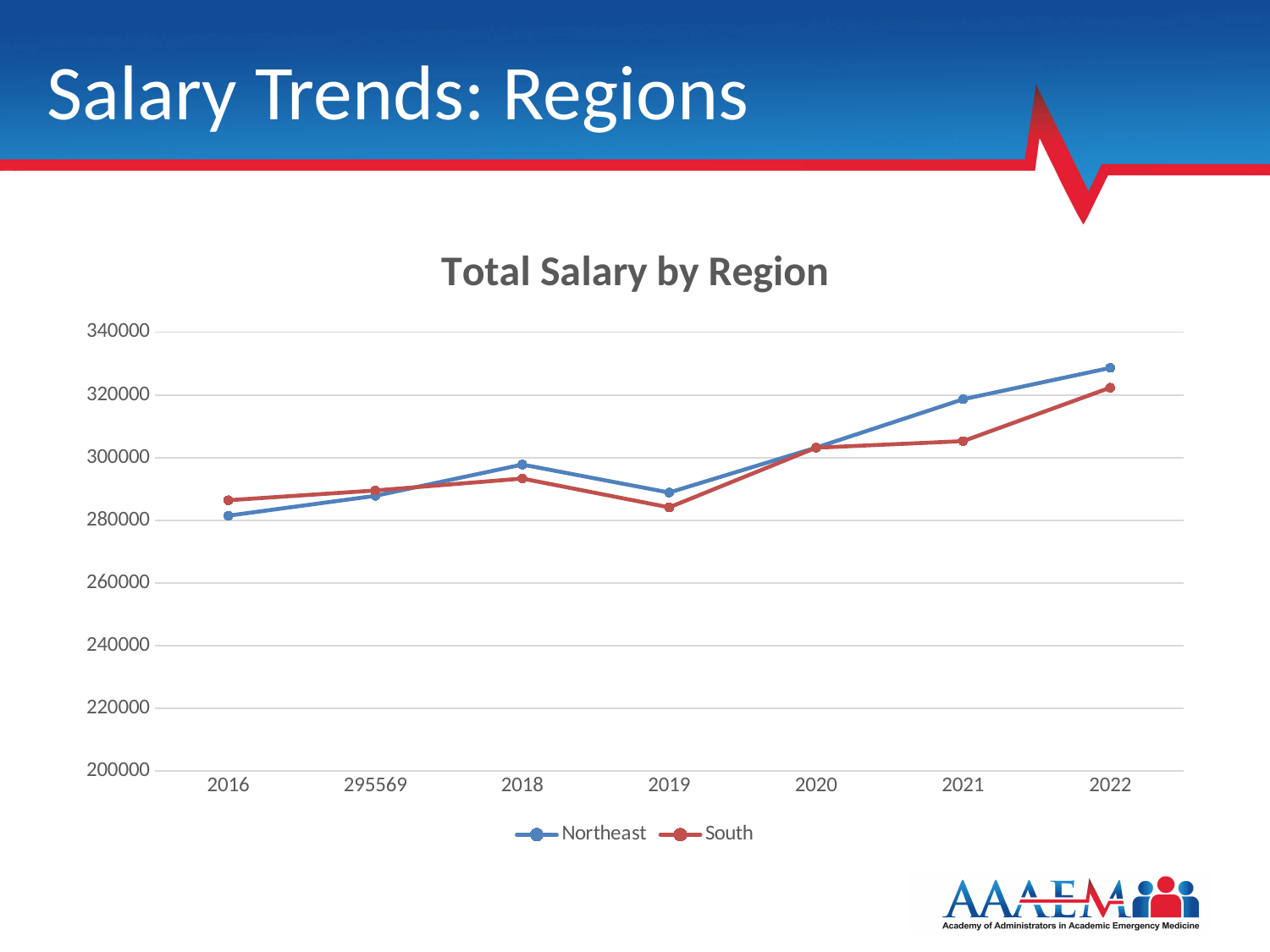
How many points are plotted for each series? 7 In which year is the South value lowest? 2019 Is the Northeast value for 2022 greater or less than 320000? greater What is the title of the chart? Total Salary by Region Which two regions are shown in the legend? Northeast and South Which region has the higher value in 2021? Northeast In which year is the Northeast value highest? 2022 Which region has the higher value in 2022? Northeast What kind of chart is shown on the slide? line chart Is the South value for 2019 greater or less than 300000? less How many series does the legend list? 2 In which year is the Northeast value lowest? 2016